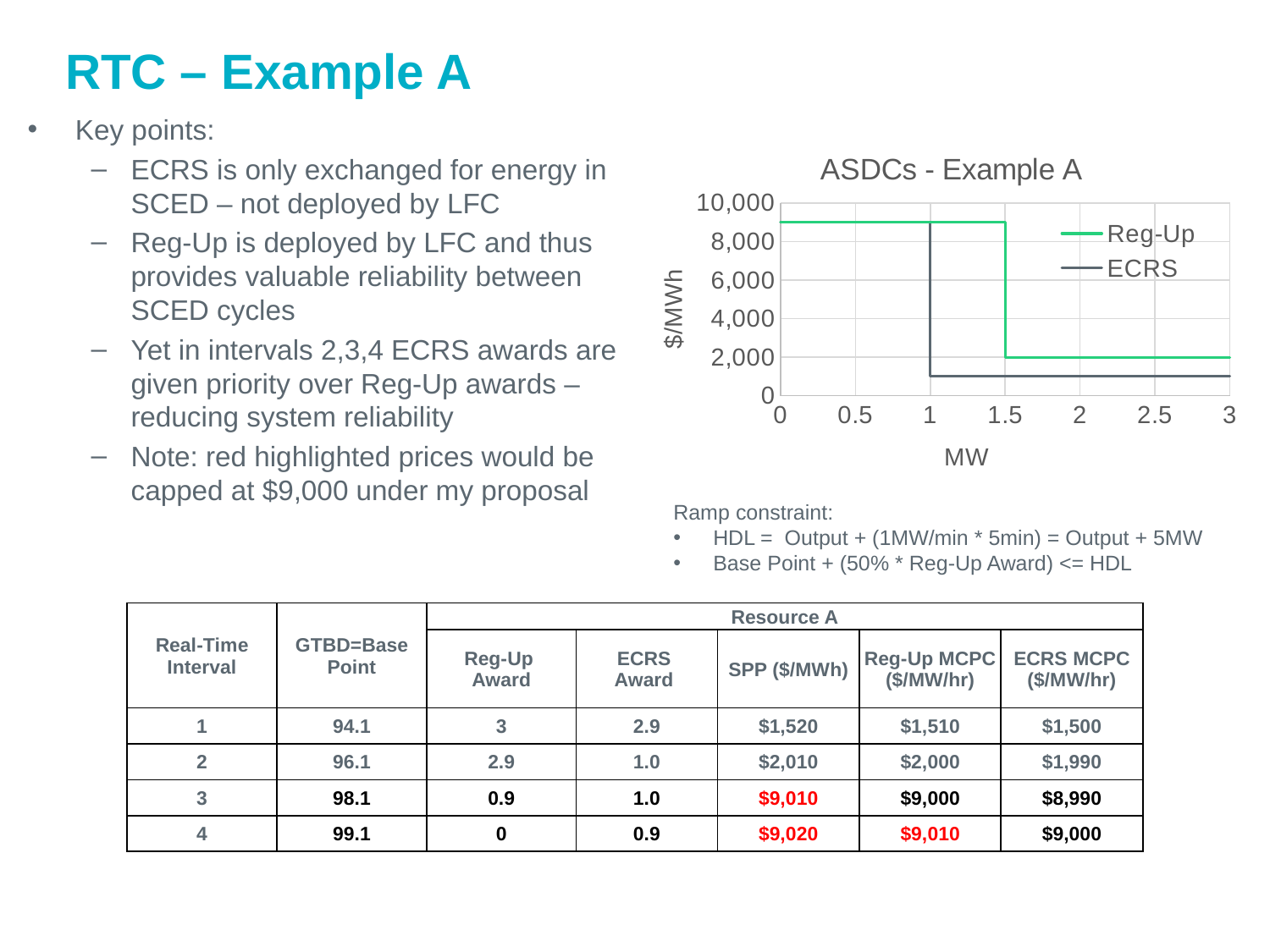
How many series does the legend of the chart list? 2 Is the ECRS value at 0.5 MW greater or less than 6,000 $/MWh? greater At 1.25 MW, which series has the higher value, Reg-Up or ECRS? Reg-Up What is the title of the chart? ASDCs - Example A Is the Reg-Up value at 2.5 MW greater or less than 4,000 $/MWh? less Is the Reg-Up value at 0.5 MW greater or less than 8,000 $/MWh? greater Do the Reg-Up values rise or fall as MW increases from 0 to 3? Fall What type of chart is shown on the slide? Line chart What are the two series named in the chart legend? Reg-Up and ECRS At 2.5 MW, which series has the higher value, Reg-Up or ECRS? Reg-Up